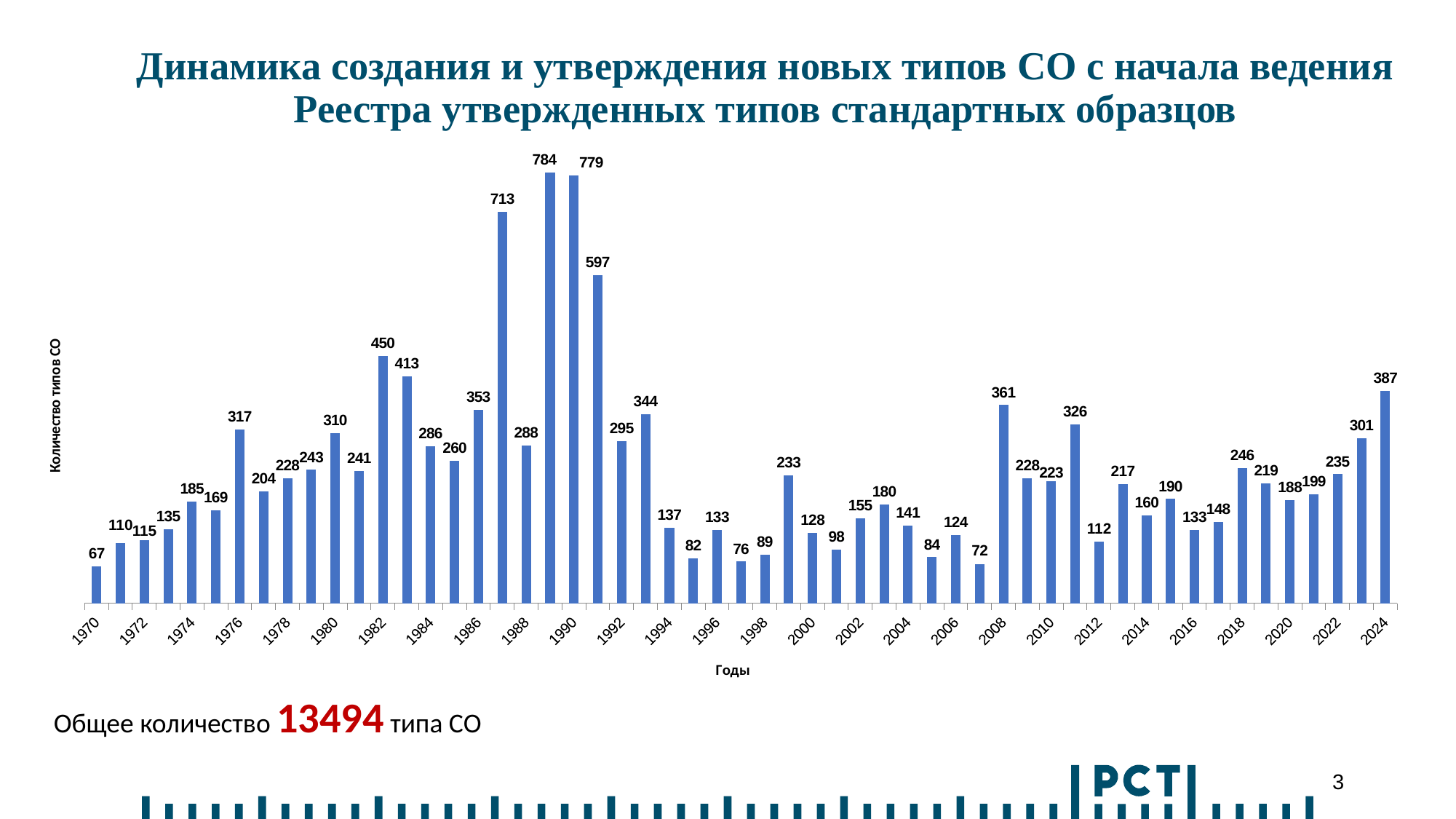
What is the value for 1970? 67 What is the label of the x axis? Годы What is the highest value shown on the chart? 784 How many bars (years) are plotted on the chart? 55 What type of chart is shown on the slide? bar chart What is the value for 1990? 779 What is the value for 2008? 361 Which is larger, the value for 1982 or the value for 1986? 1982 What is the difference between the values for 2024 and 2022? 152 Which year has the lowest value on the chart? 1970 What total number of CO types is stated below the chart? 13494 What is the value for 2024? 387